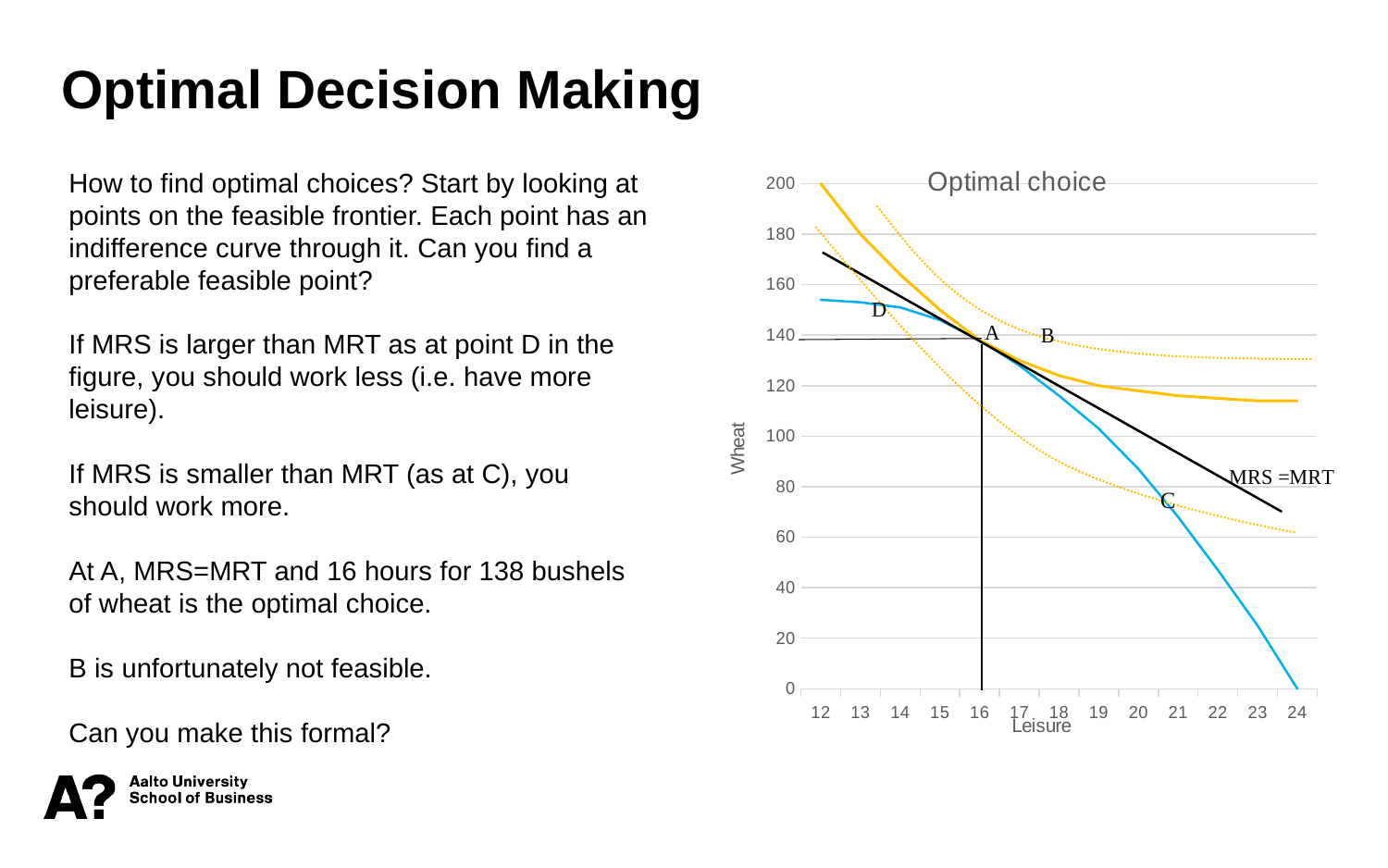
What is the title of the chart? Optimal choice What kind of chart is shown on the slide? line chart Is the Wheat value at point D greater or less than 140? greater Does the blue curve rise or fall as Leisure increases from 12 to 24? fall Which of the labeled points A, B, C and D has the lowest Wheat value? C What Wheat value does the blue curve reach at Leisure 24? 0 What label is written next to the black straight line in the chart? MRS =MRT Which of the labeled points, D or C, has the higher Wheat value? D How many labeled points (letters) are marked on the chart? 4 Is the Wheat value at point C greater or less than 100? less What is the highest Leisure value shown on the x axis? 24 At what Leisure value on the x axis is point A located? 16